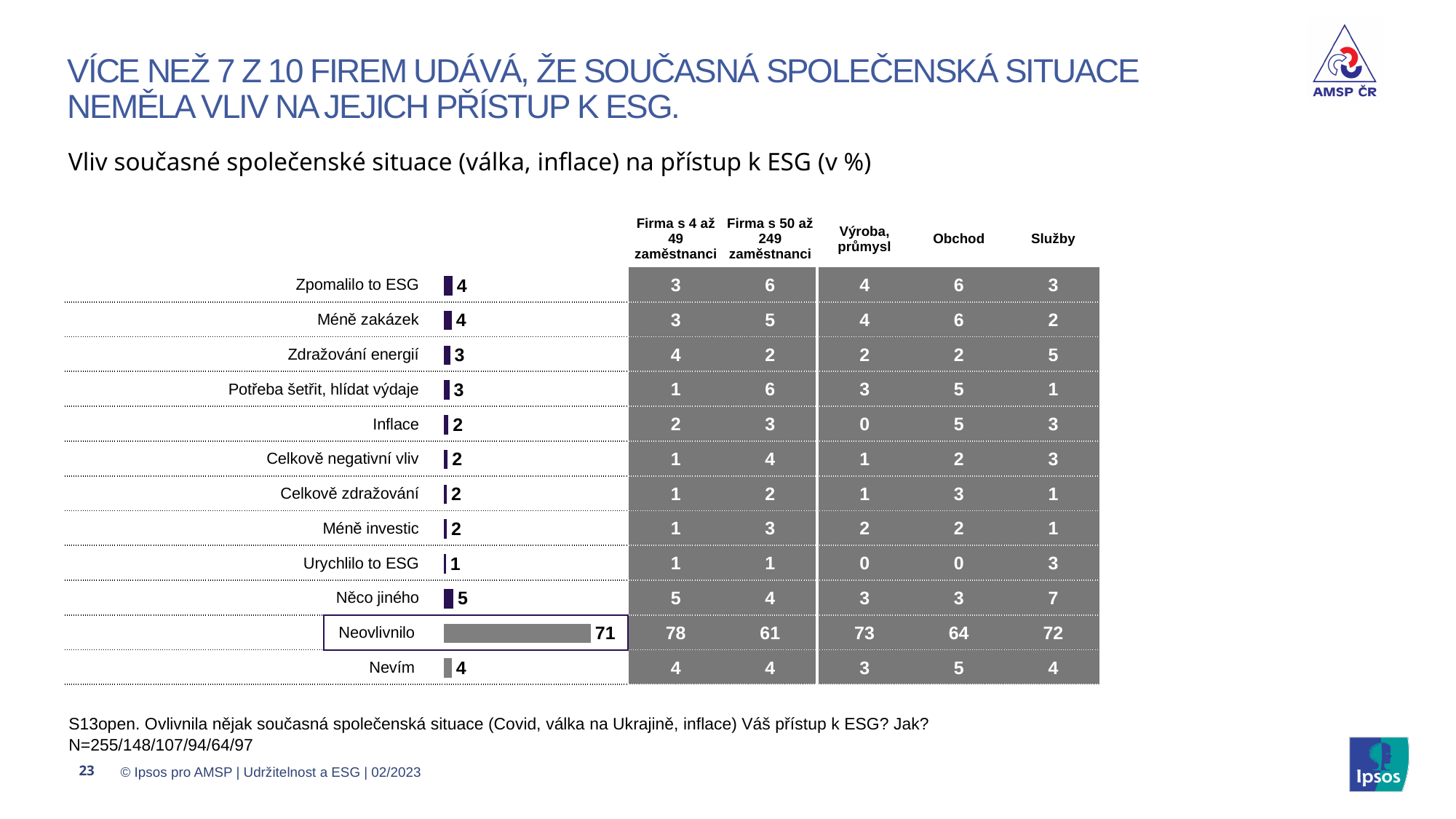
What is the difference between the values for "Zpomalilo to ESG" and "Inflace" in the bar chart? 2 How many categories are shown in the bar chart? 12 What is the value shown for "Urychlilo to ESG" in the bar chart? 1 What is the value shown for "Zdražování energií" in the bar chart? 3 What is the value shown for "Něco jiného" in the bar chart? 5 What is the value shown for "Neovlivnilo" in the bar chart? 71 What is the difference between the values for "Neovlivnilo" and "Něco jiného" in the bar chart? 66 What is the title of the chart on the slide? Vliv současné společenské situace (válka, inflace) na přístup k ESG (v %) Which has a larger value in the bar chart, "Něco jiného" or "Méně investic"? Něco jiného Which category has the lowest value in the bar chart? Urychlilo to ESG What type of chart is shown on the slide? Bar chart Which category has the highest value in the bar chart? Neovlivnilo